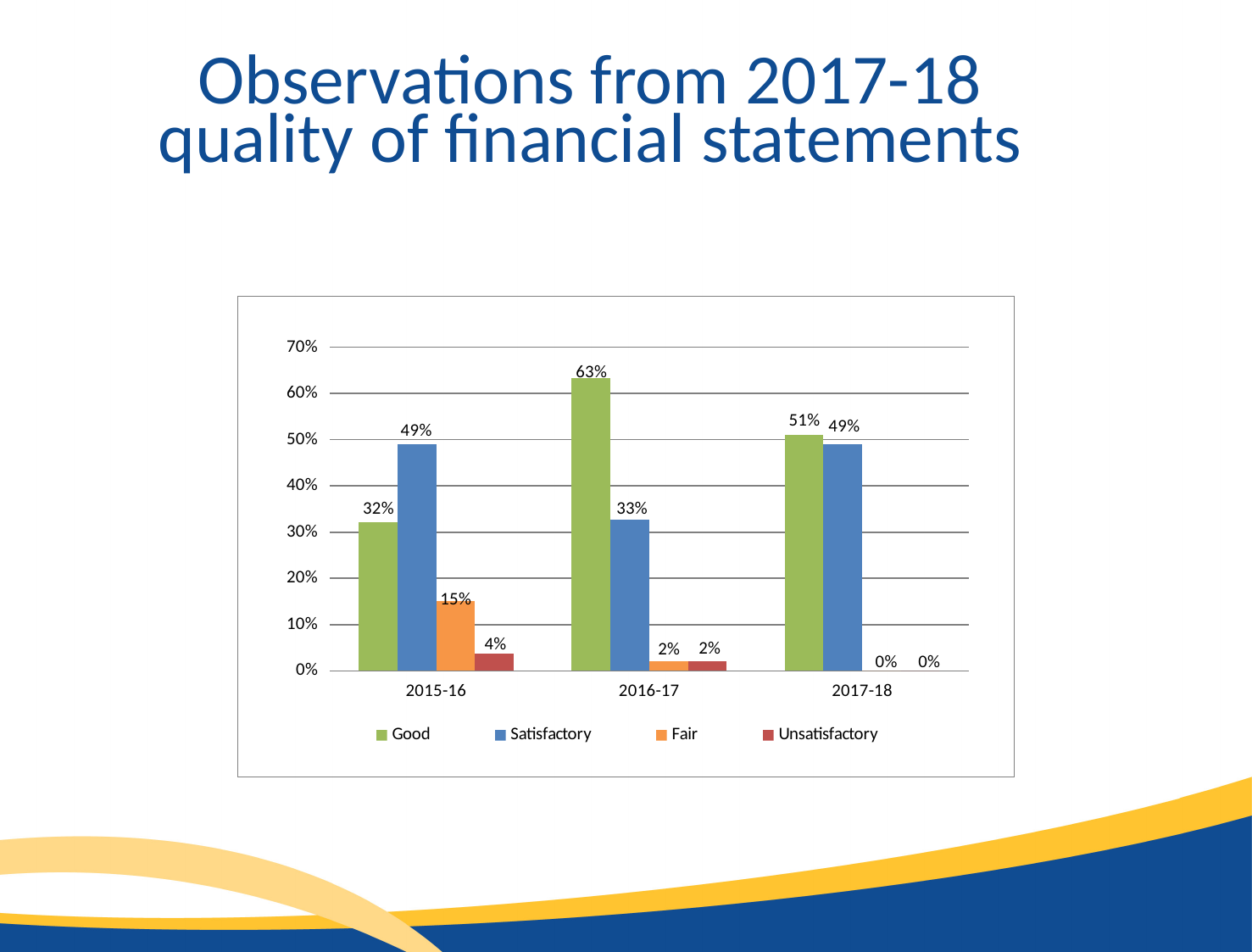
What kind of chart is shown on the slide? Bar chart In which year is the value for Satisfactory lowest? 2016-17 What is the value for Satisfactory in 2015-16? 49% Which is larger in 2015-16, Good or Satisfactory? Satisfactory What is the difference between the Good values for 2016-17 and 2015-16? 31% What is the value for Fair in 2015-16? 15% In which year is the value for Good highest? 2016-17 Is the value for Good in 2017-18 greater or less than 40%? greater What is the value for Unsatisfactory in 2017-18? 0% What is the value for Good in 2016-17? 63% How many series does the legend list? 4 How many years are shown on the x axis? 3